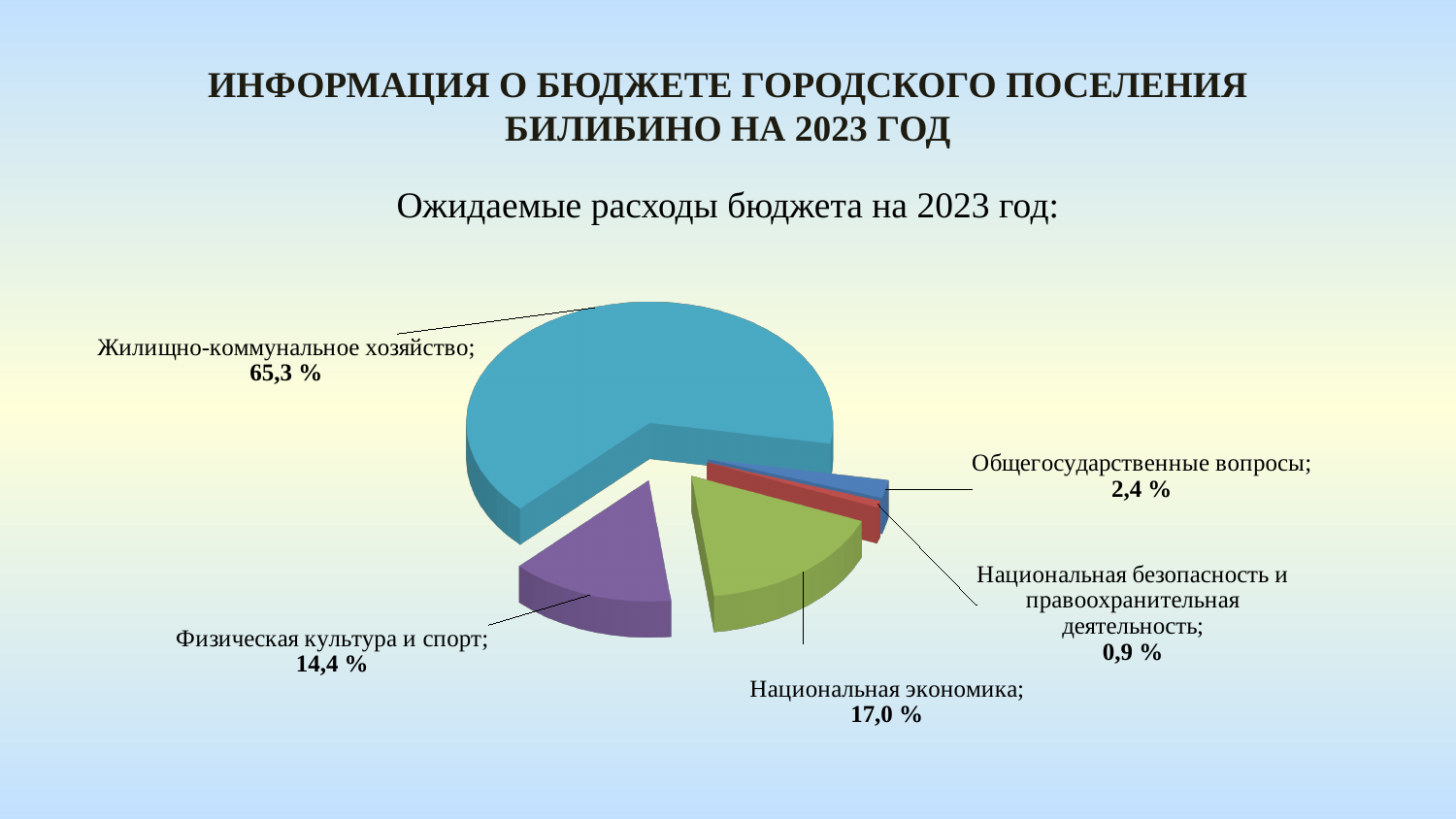
What type of chart is shown on the slide? Pie chart Which is larger: the share for Общегосударственные вопросы or for Национальная безопасность и правоохранительная деятельность? Общегосударственные вопросы How many categories are shown in the pie chart? 5 What share is shown for Общегосударственные вопросы? 2,4 % What percentage is given for Национальная безопасность и правоохранительная деятельность? 0,9 % Which category has the largest share of the pie? Жилищно-коммунальное хозяйство What percentage is shown for Национальная экономика? 17,0 % What is the difference in percentage points between Национальная экономика and Физическая культура и спорт? 2,6 What share of expected 2023 budget expenditures goes to Жилищно-коммунальное хозяйство? 65,3 % What value is labelled for Физическая культура и спорт? 14,4 % Which category has the smallest share of the pie? Национальная безопасность и правоохранительная деятельность What is the subtitle above the chart? Ожидаемые расходы бюджета на 2023 год: